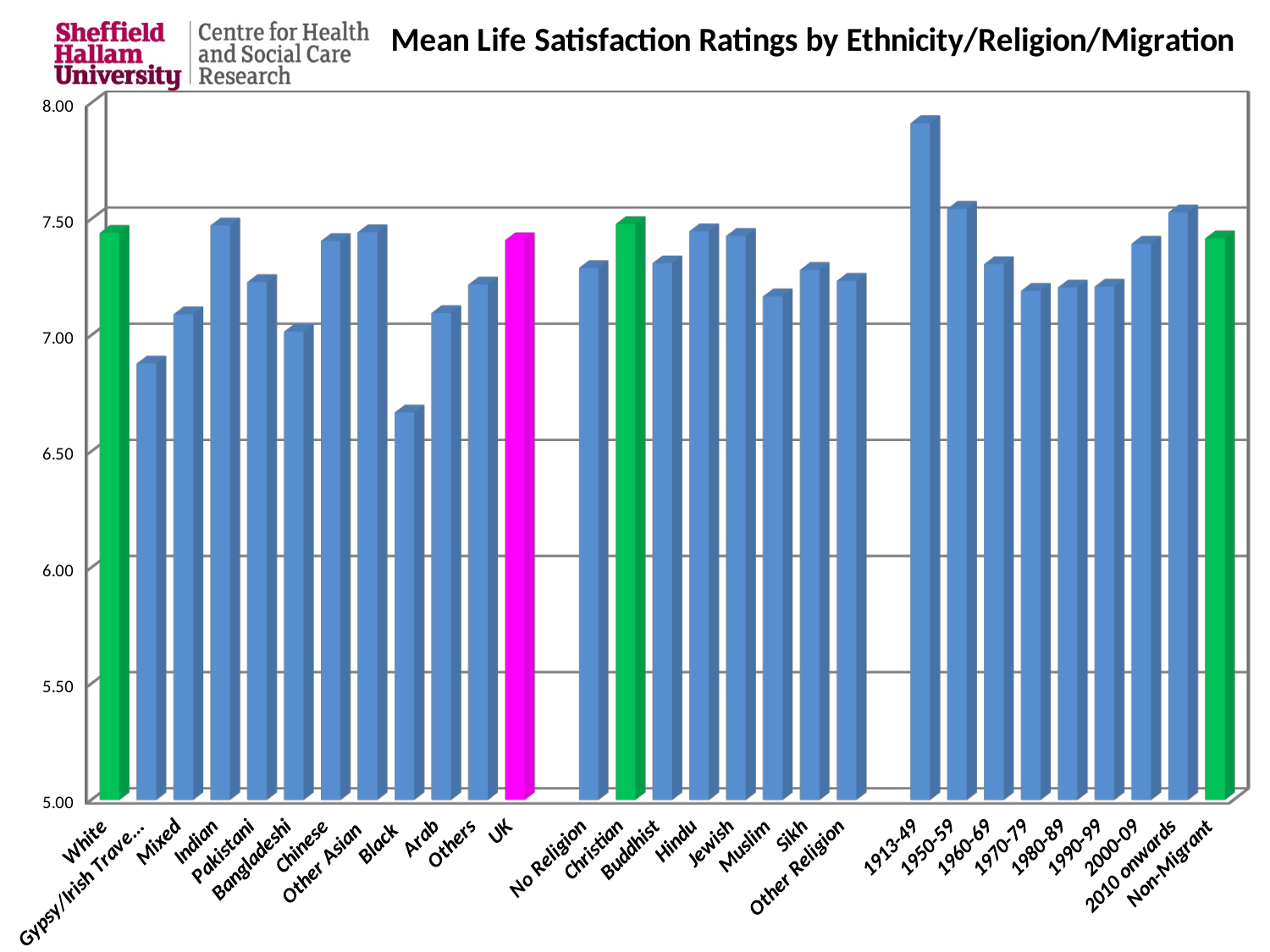
What colour is the bar for UK? Magenta Which has a higher mean life satisfaction rating, Indian or Black? Indian What type of chart is shown on the slide? Bar chart Which category has the lowest mean life satisfaction rating? Black Which has a higher mean life satisfaction rating, Jewish or Muslim? Jewish What is the title of the chart? Mean Life Satisfaction Ratings by Ethnicity/Religion/Migration Which has a higher mean life satisfaction rating, 1913-49 or 1950-59? 1913-49 Is the value for Muslim greater or less than 7.50? less Is the value for 1913-49 greater or less than 7.50? greater Is the value for Gypsy/Irish Traveller greater or less than 7.00? less Which category has the highest mean life satisfaction rating? 1913-49